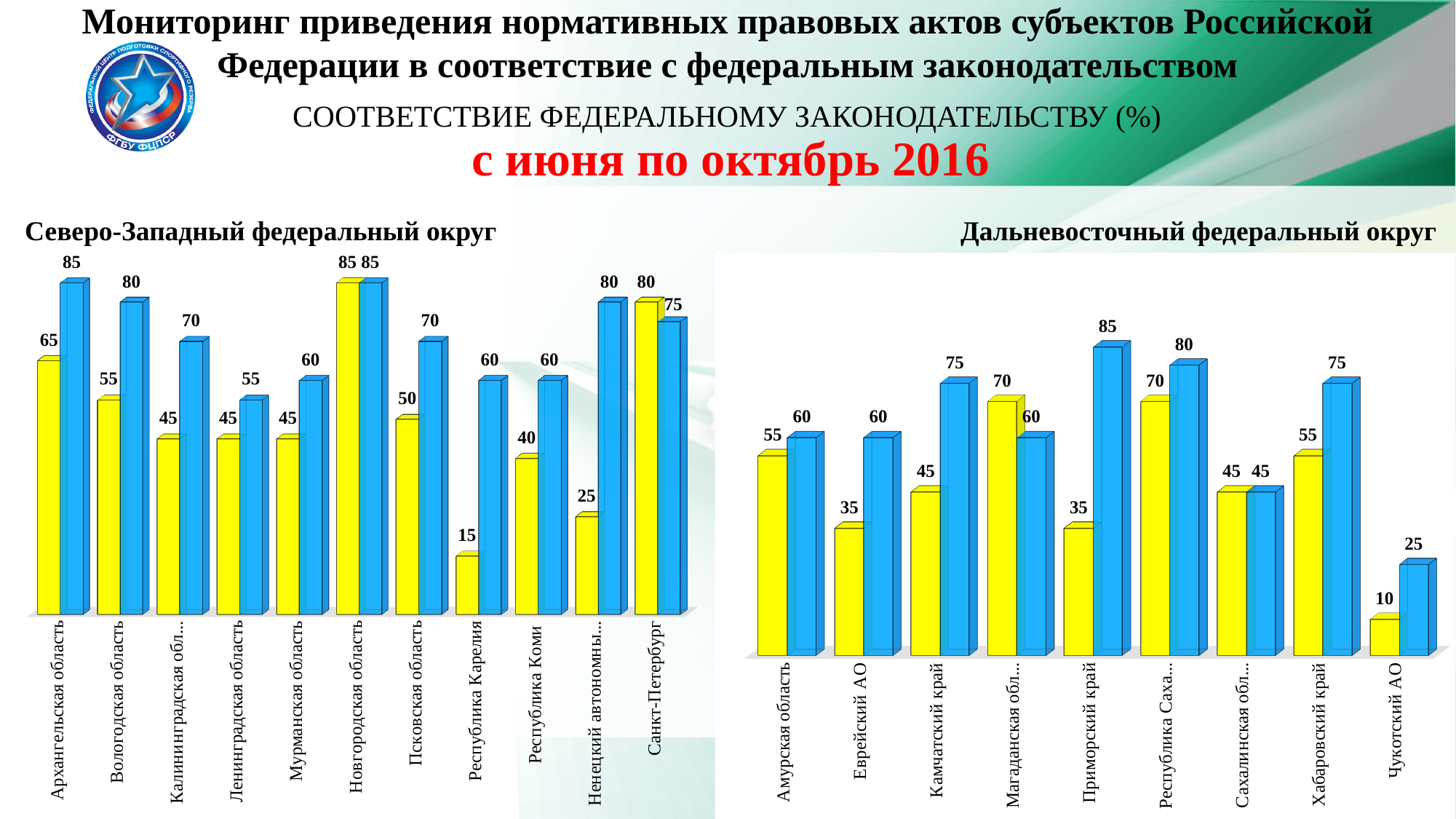
In the Северо-Западный федеральный округ chart, what is the difference between the blue and yellow bars for Ненецкий автономный округ? 55 In the Северо-Западный федеральный округ chart, what is the value of the blue bar for Архангельская область? 85 In the Северо-Западный федеральный округ chart, which is larger for Санкт-Петербург, the yellow bar or the blue bar? the yellow bar How many categories are shown in the Северо-Западный федеральный округ chart? 11 In the Дальневосточный федеральный округ chart, what is the difference between the blue and yellow bars for Камчатский край? 30 In the Северо-Западный федеральный округ chart, what is the value of the yellow bar for Республика Карелия? 15 How many categories are shown in the Дальневосточный федеральный округ chart? 9 In the Северо-Западный федеральный округ chart, which category has the lowest yellow bar? Республика Карелия What type of chart is the Дальневосточный федеральный округ chart? bar chart In the Дальневосточный федеральный округ chart, which category has the highest blue bar? Приморский край In the Дальневосточный федеральный округ chart, what is the value of the yellow bar for Чукотский АО? 10 In the Дальневосточный федеральный округ chart, what is the value of the blue bar for Приморский край? 85